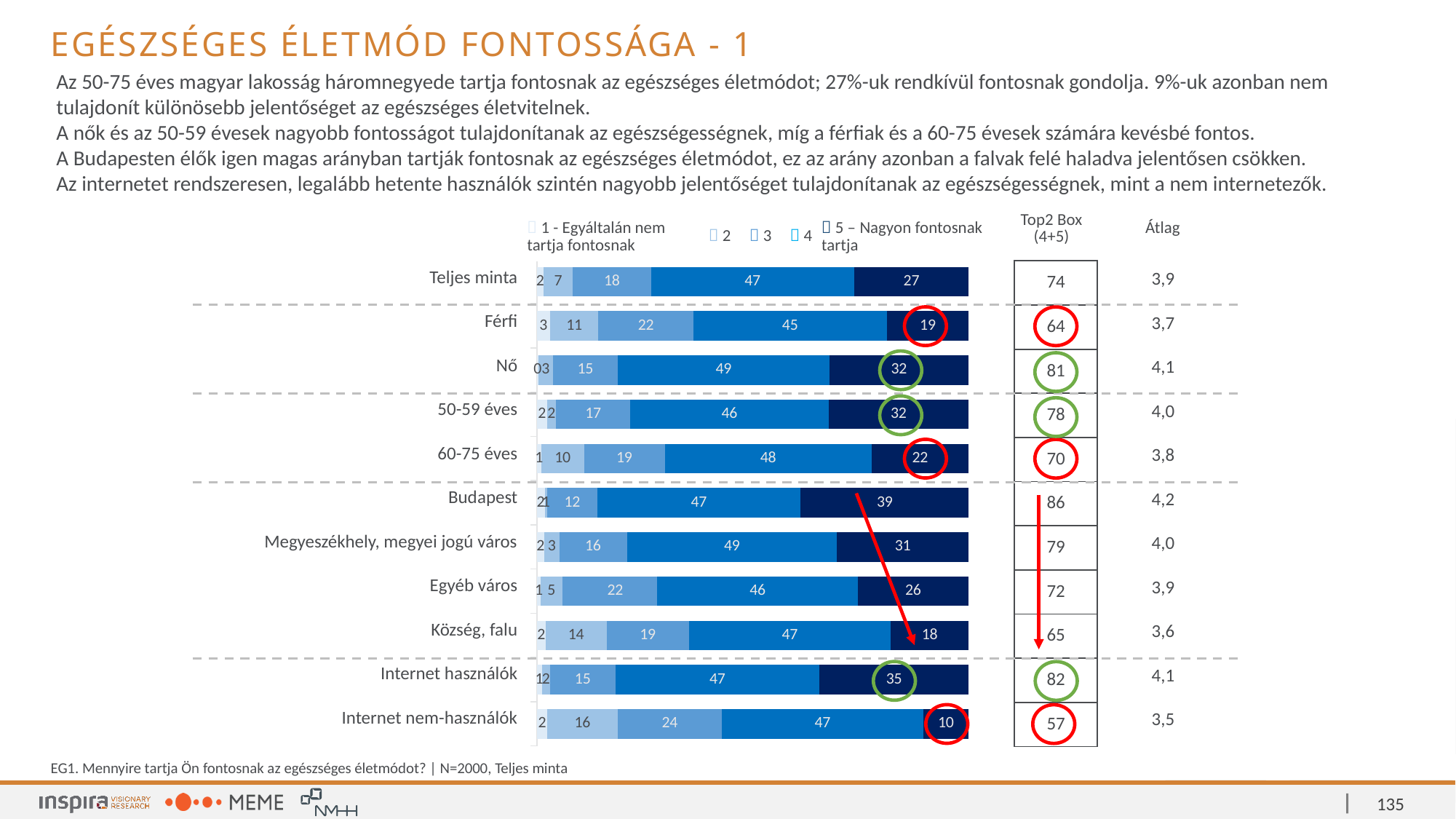
Which category has the highest value for the '5 – Nagyon fontosnak tartja' segment? Budapest What kind of chart is shown on the slide? stacked bar chart How many categories (rows) does the bar chart show? 11 What is the value of the '5 – Nagyon fontosnak tartja' segment for Teljes minta? 27 What is the value of the '4' segment for Nő? 49 What is the difference between the '5 – Nagyon fontosnak tartja' values for Nő and Férfi? 13 What is the label of the first legend entry in the chart? 1 - Egyáltalán nem tartja fontosnak How many series does the chart legend list? 5 What is the difference between the '5 – Nagyon fontosnak tartja' values for Budapest and Község, falu? 21 What is the value of the '2' segment for Község, falu? 14 Which category has the lowest value for the '5 – Nagyon fontosnak tartja' segment? Internet nem-használók Which has a larger '3' segment value, Internet nem-használók or Internet használók? Internet nem-használók